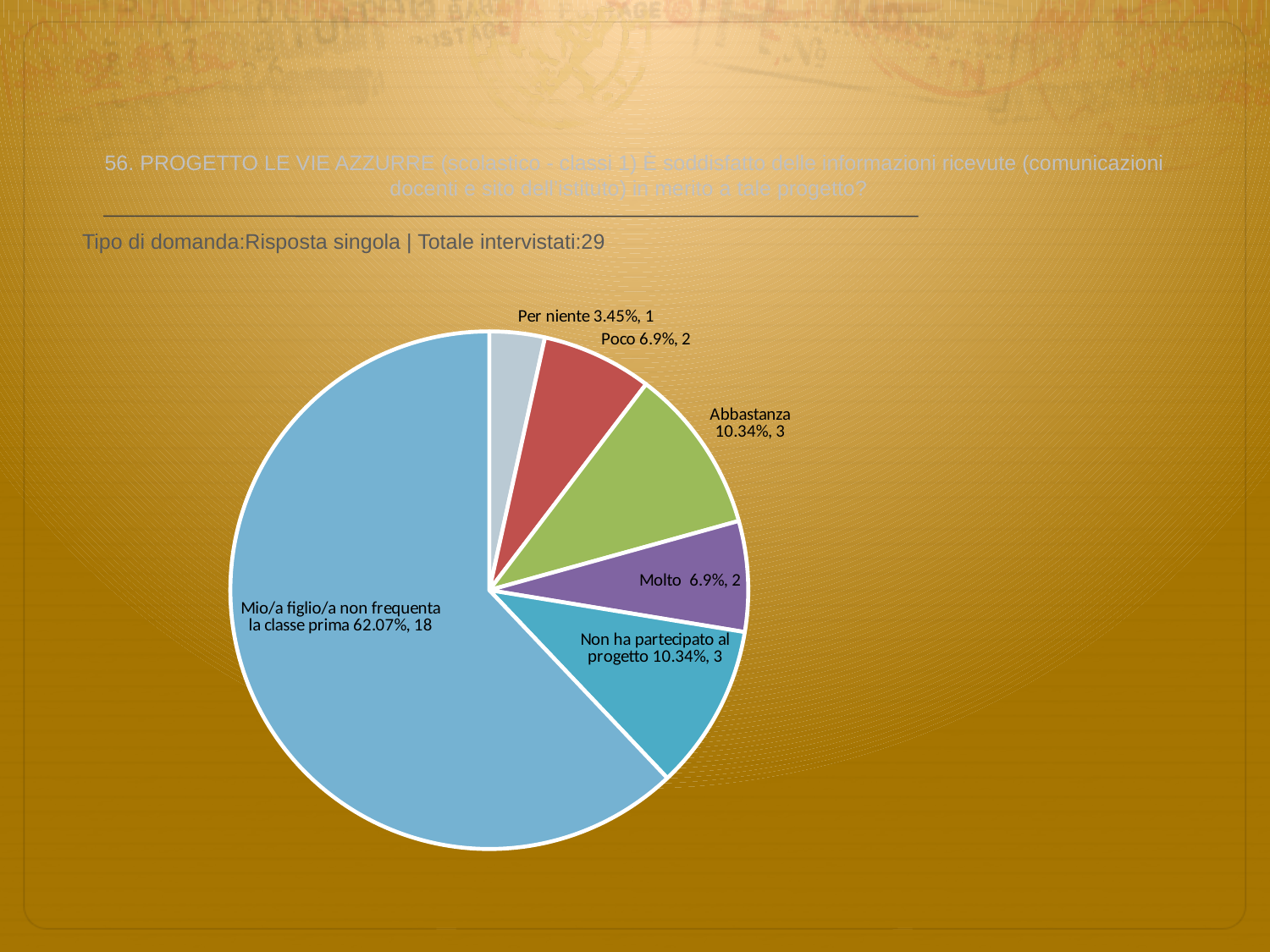
What is the total number of respondents stated on the slide? 29 What percentage is shown for 'Per niente'? 3.45% Which has more respondents, 'Poco' or 'Abbastanza'? Abbastanza How many respondents chose 'Non ha partecipato al progetto'? 3 How many respondents chose 'Abbastanza'? 3 Which category has the largest slice? Mio/a figlio/a non frequenta la classe prima Which category has the smallest slice? Per niente What kind of chart is shown on the slide? pie chart What percentage is shown for 'Molto'? 6.9% What percentage share does the 'Mio/a figlio/a non frequenta la classe prima' slice have? 62.07% What is the difference in respondent count between 'Mio/a figlio/a non frequenta la classe prima' and 'Abbastanza'? 15 How many slices does the pie chart have? 6